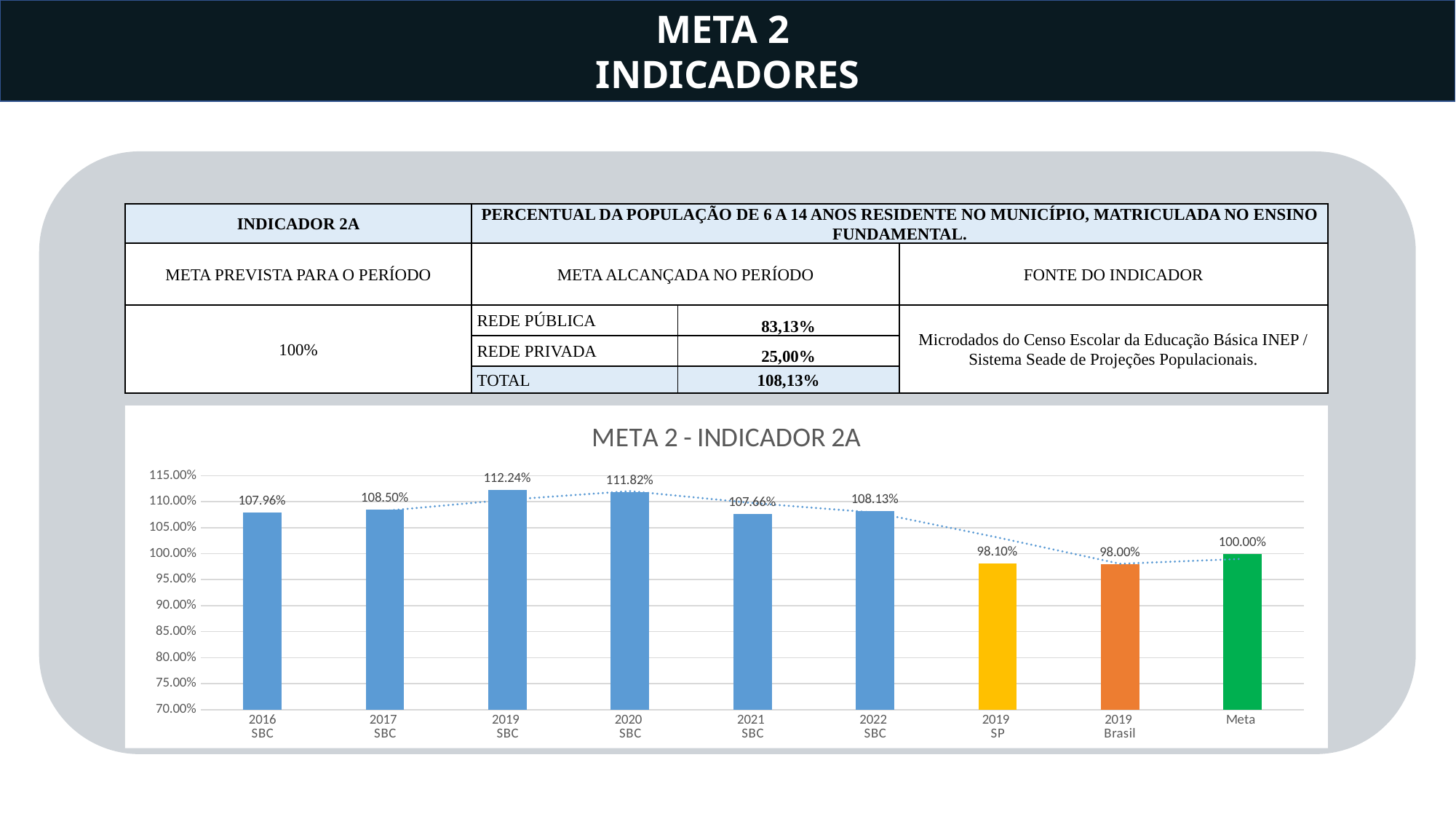
Which category has the lowest value in the chart? 2019 Brasil How many categories are shown on the x axis of the chart? 9 What is the title of the chart? META 2 - INDICADOR 2A What is the difference between the values for 2019 SBC and 2020 SBC? 0.42% What is the value for 2016 SBC in the chart? 107.96% Which is larger, the value for 2017 SBC or the value for 2021 SBC? 2017 SBC What kind of chart is shown on the slide? bar chart Is the value for 2022 SBC greater or less than 105.00%? greater What is the value for 2019 Brasil in the chart? 98.00% Which category has the highest value in the chart? 2019 SBC What is the value for Meta in the chart? 100.00% What is the value for 2019 SP in the chart? 98.10%